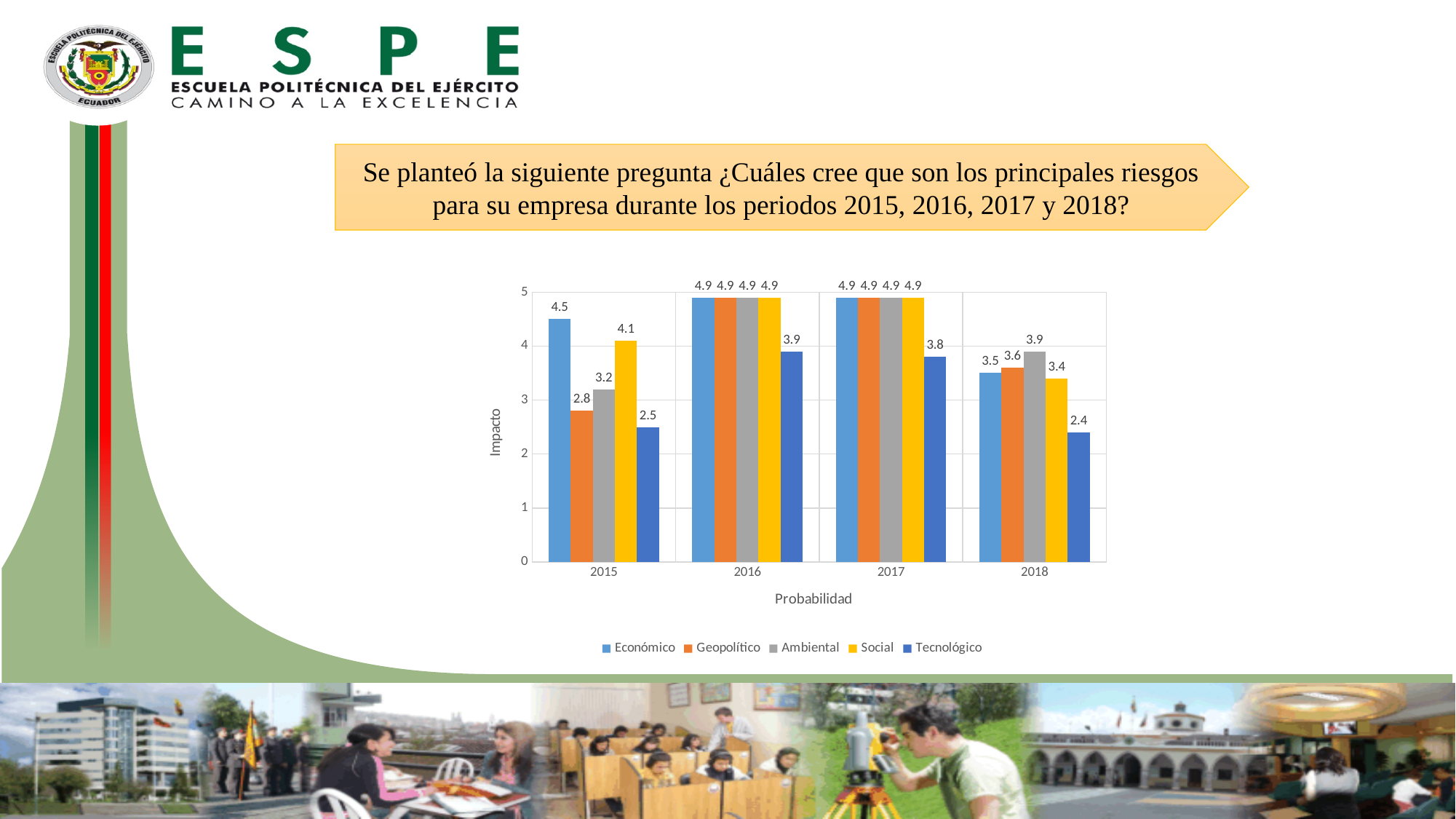
Is the value for Tecnológico in 2015 greater or less than 3? less How many series does the legend list? 5 Which is larger, the Tecnológico value in 2016 or in 2017? 2016 What is the value for Tecnológico in 2018? 2.4 Which series has the lowest value in 2015? Tecnológico What is the difference between the Económico and Geopolítico values in 2015? 1.7 What is the value for Social in 2015? 4.1 What type of chart is shown on the slide? bar chart What is the value for Ambiental in 2018? 3.9 What is the value for Económico in 2015? 4.5 Which series has the highest value in 2018? Ambiental How many year categories are shown on the x axis? 4